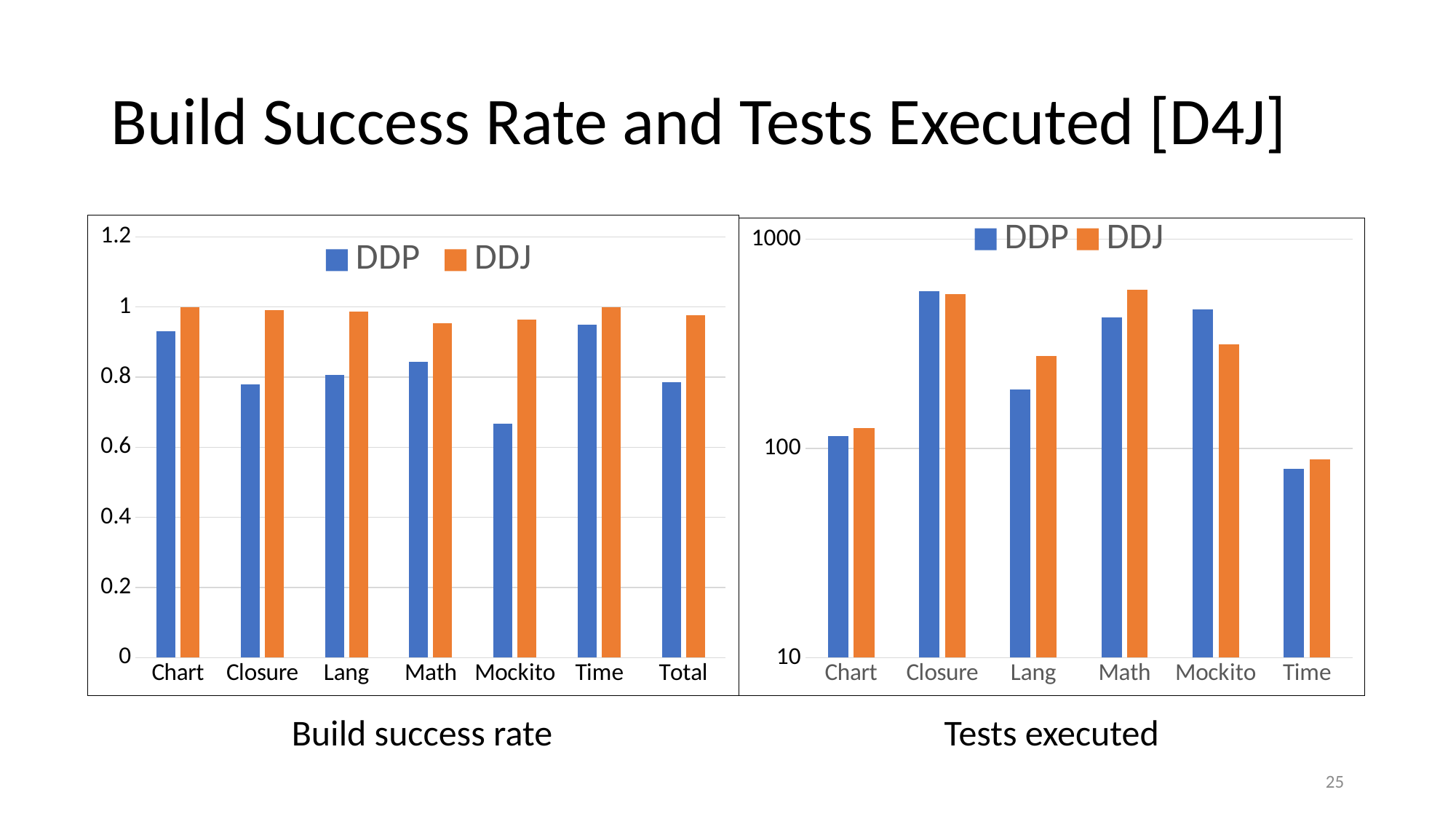
In the Tests executed chart, which category has the lowest DDP value? Time In the Build success rate chart, which category has the lowest DDP value? Mockito In the Build success rate chart, is the DDP value for Mockito greater or less than 0.8? less In the Tests executed chart, which is larger for Mockito, DDP or DDJ? DDP How many categories are shown on the x axis of the Build success rate chart? 7 In the Tests executed chart, is the DDP value for Time greater or less than 100? less How many series does the legend of the Tests executed chart list? 2 In the Build success rate chart, is the DDP value for Chart greater or less than 0.8? greater What kind of chart is the Build success rate chart on the left? bar chart How many categories are shown on the x axis of the Tests executed chart? 6 Which series is shown in orange in the Tests executed chart? DDJ In the Build success rate chart, which is larger for Mockito, DDP or DDJ? DDJ